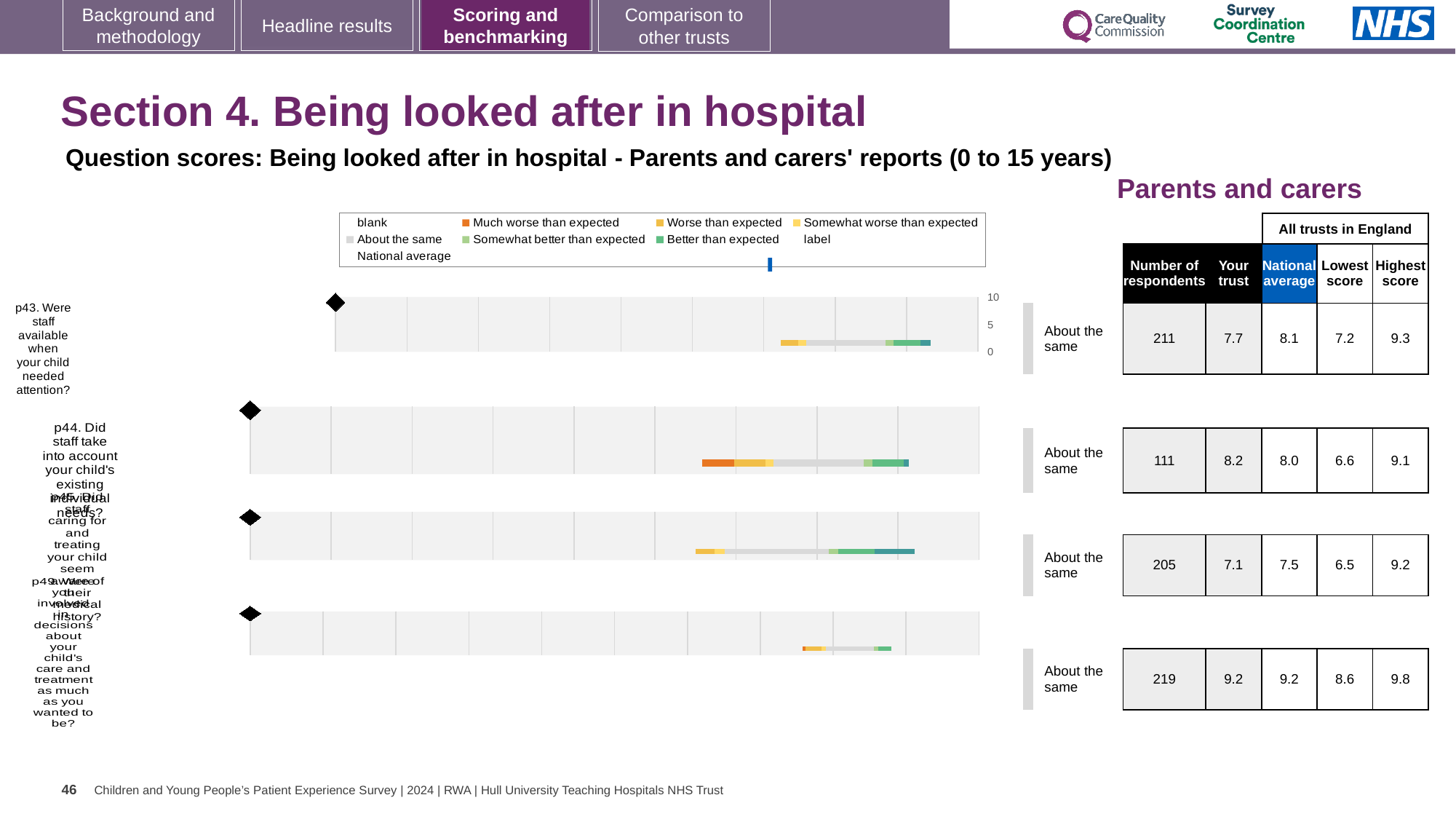
In the legend, which colour represents 'Much worse than expected'? Orange What is the highest score across all trusts in England for p44? 9.1 Which question has the highest 'Your trust' score? p49 Which question has the lowest number of respondents? p44 For p44, which is larger: the 'Your trust' score or the national average? Your trust What is the 'Your trust' score for p43 (Were staff available when your child needed attention?)? 7.7 How many respondents answered p49 (Were you involved in decisions about your child's care and treatment as much as you wanted to be?)? 219 What is the national average score for p45 (Did staff caring for and treating your child seem aware of their medical history?)? 7.5 What benchmark category is shown for p45? About the same What kind of chart is used to show the benchmarking results for each question on this slide? Bar chart What is the difference between the highest score and the lowest score for p43? 2.1 How many questions (p43, p44, p45, p49) have a benchmarking bar chart on this slide? 4